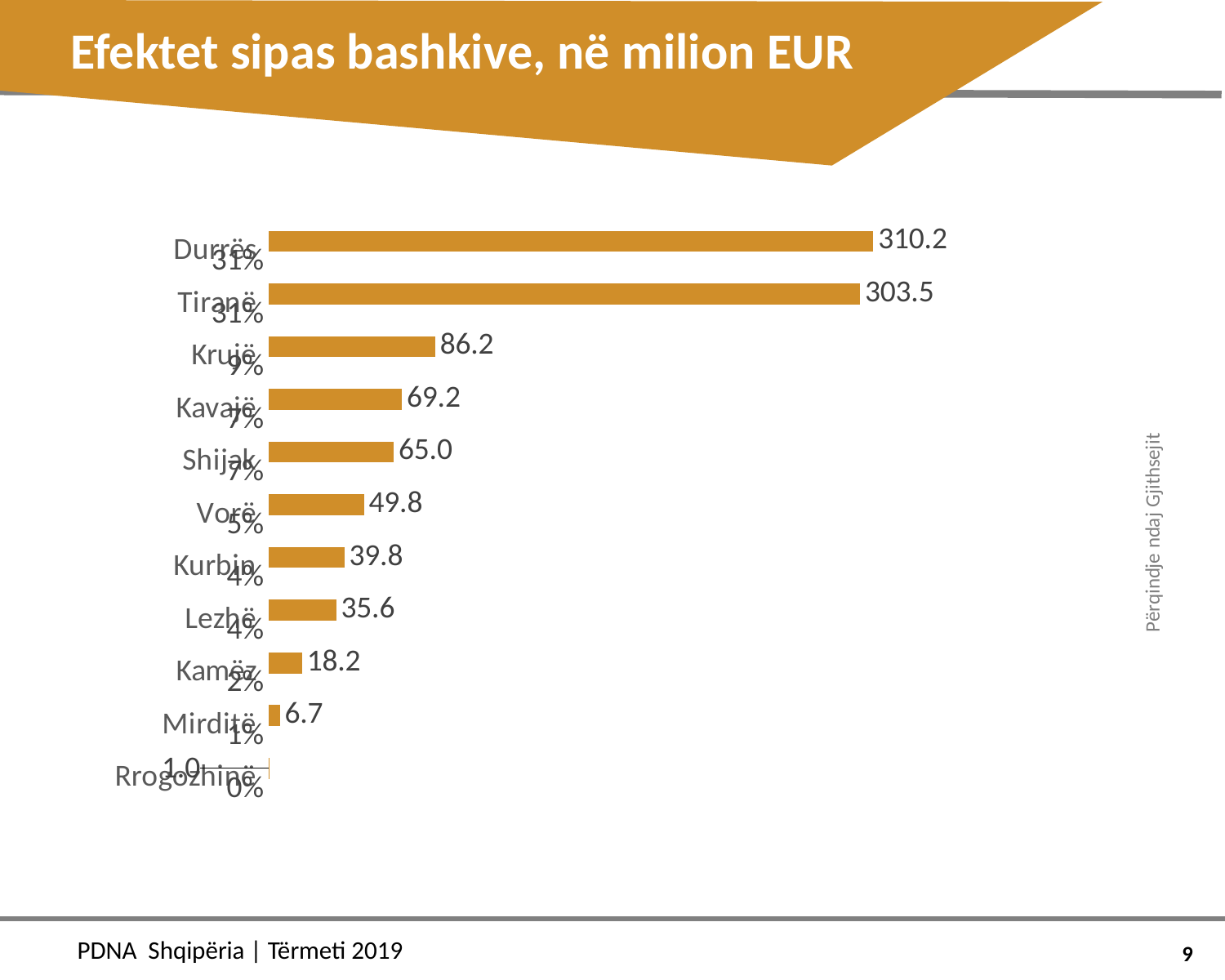
Which is larger, the value for Vorë or the value for Kurbin? Vorë Which municipality has the lowest value? Rrogozhinë What is the title of the slide? Efektet sipas bashkive, në milion EUR Which municipality has the highest value? Durrës What is the value for Durrës? 310.2 How many municipalities are shown in the chart? 11 What is the value for Shijak? 65.0 What kind of chart is shown on the slide? Bar chart What is the difference between the values for Durrës and Tiranë? 6.7 What is the difference between the values for Kavajë and Shijak? 4.2 What is the value for Kamëz? 18.2 What is the value for Krujë? 86.2